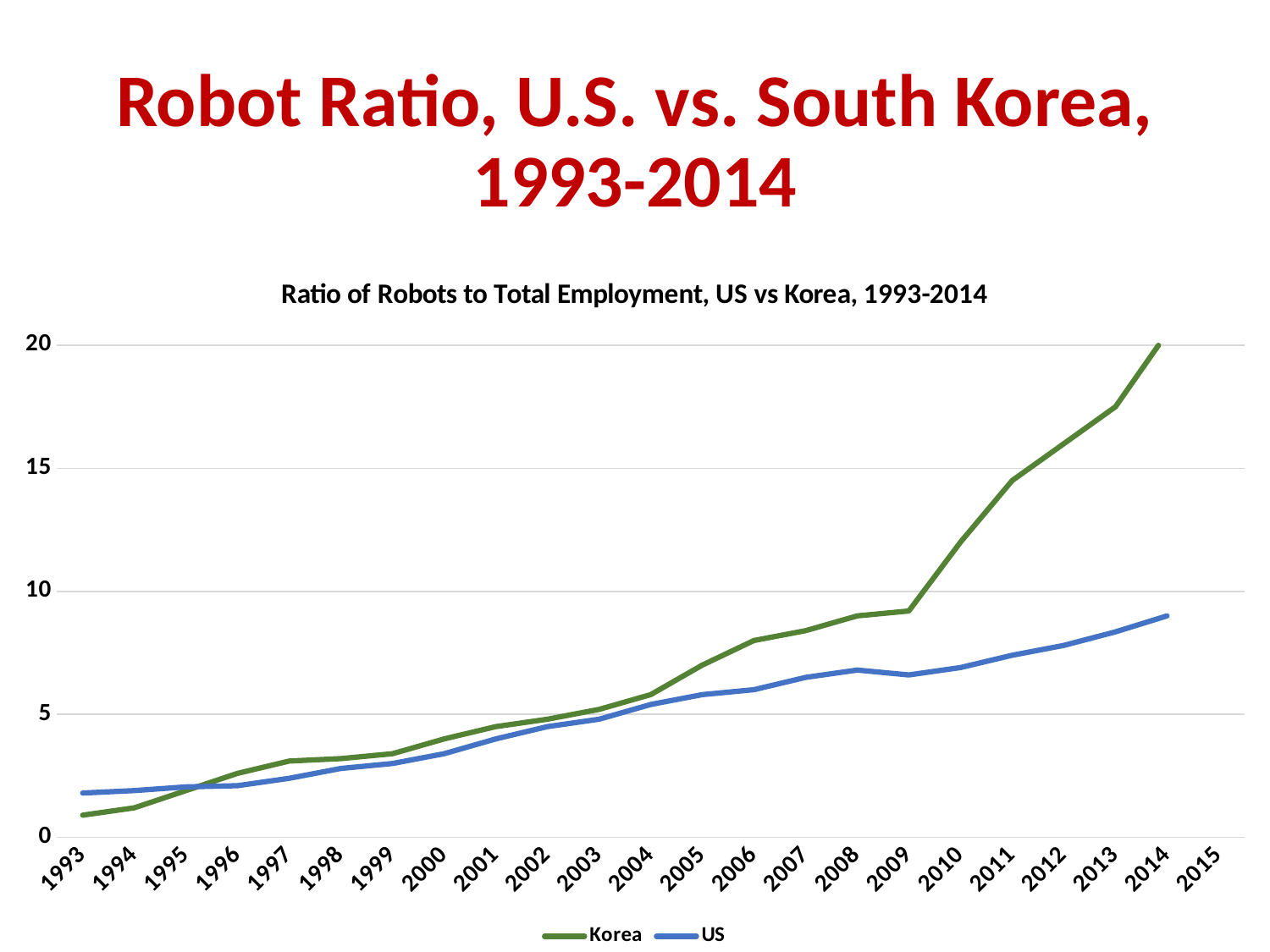
How many series does the legend list? 2 Does the Korea line generally rise or fall from 1993 to 2014? rise Is the value for Korea in 2009 greater or less than 10? less Is the value for Korea in 2014 greater or less than 15? greater What is the title printed above the chart area? Ratio of Robots to Total Employment, US vs Korea, 1993-2014 In 2014, which series has the higher value, Korea or US? Korea Is the value for US in 2014 greater or less than 10? less In 1993, which series has the higher value, Korea or US? US What kind of chart is shown on the slide? line chart What are the two series named in the legend? Korea and US